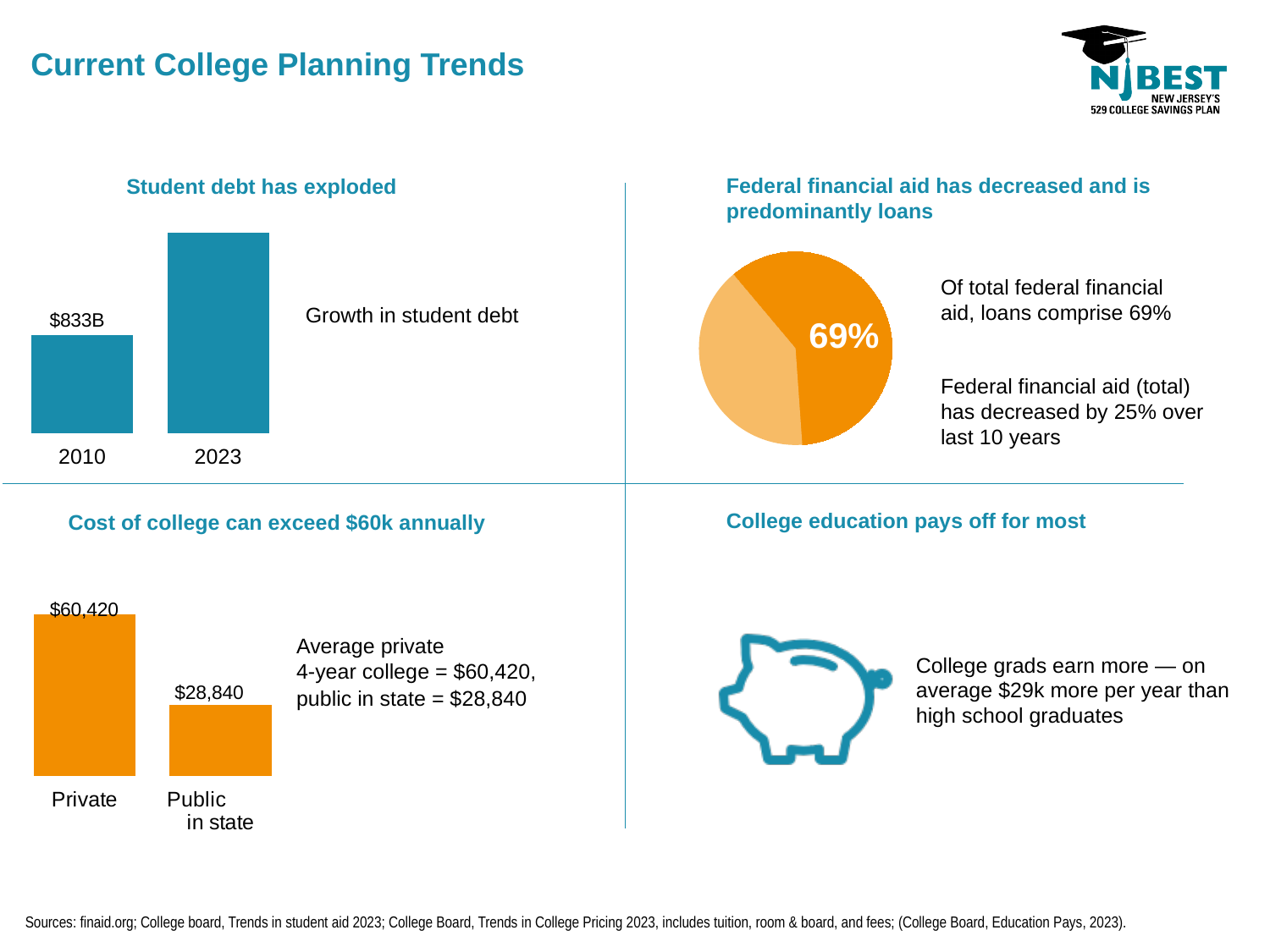
In the 'Cost of college can exceed $60k annually' chart, what colour are the bars? Orange In the 'Cost of college can exceed $60k annually' chart, which category has the lowest value? Public in state What kind of chart is used under 'Student debt has exploded'? Bar chart In the 'Cost of college can exceed $60k annually' chart, what is the value for Public in state? $28,840 In the pie chart under 'Federal financial aid has decreased and is predominantly loans', what percentage is labelled on the larger slice? 69% In the 'Student debt has exploded' chart, does student debt rise or fall from 2010 to 2023? Rise What kind of chart is shown under 'Federal financial aid has decreased and is predominantly loans'? Pie chart In the 'Cost of college can exceed $60k annually' chart, what is the value for Private? $60,420 In the 'Student debt has exploded' chart, which year has the taller bar? 2023 In the 'Cost of college can exceed $60k annually' chart, what is the difference between the Private and Public in state values? $31,580 In the 'Student debt has exploded' chart, what is the value shown for 2010? $833B In the 'Student debt has exploded' chart, how many bars are plotted? 2